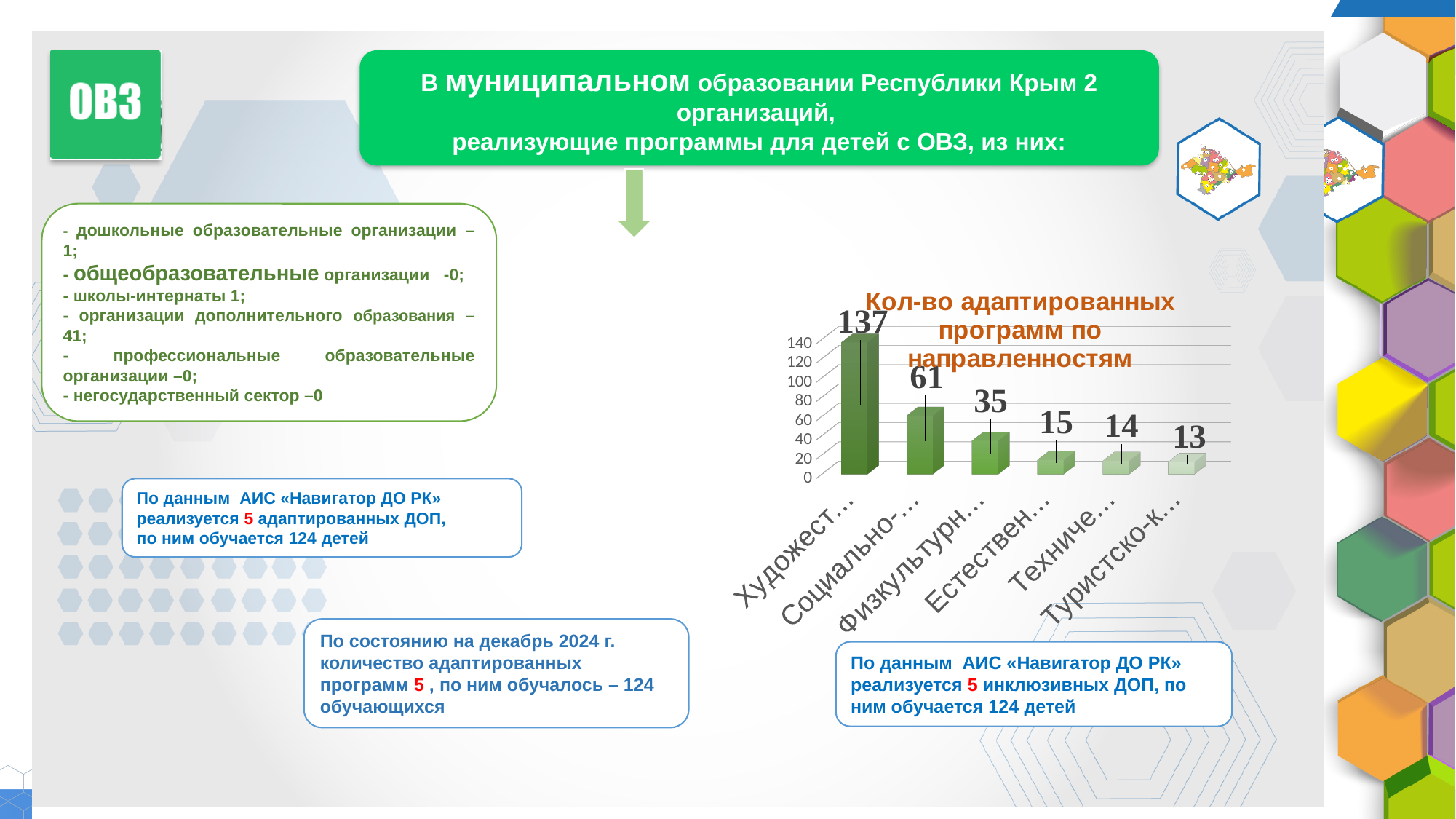
Which category has the lowest value in the chart? Туристско-к… What is the value for the category labelled "Художест…" in the chart "Кол-во адаптированных программ по направленностям"? 137 Do the values rise or fall from left to right along the x axis? fall What is the value for the category labelled "Туристско-к…"? 13 How many categories are shown in the chart? 6 What is the value for the category labelled "Социально-…"? 61 What kind of chart is shown on the slide? bar chart What is the value for the category labelled "Физкультурн…"? 35 Which category has the highest value in the chart? Художест… Which is larger, the value for "Естествен…" or the value for "Техниче…"? Естествен… What is the difference between the values for "Художест…" and "Социально-…"? 76 What is the difference between the values for "Физкультурн…" and "Туристско-к…"? 22